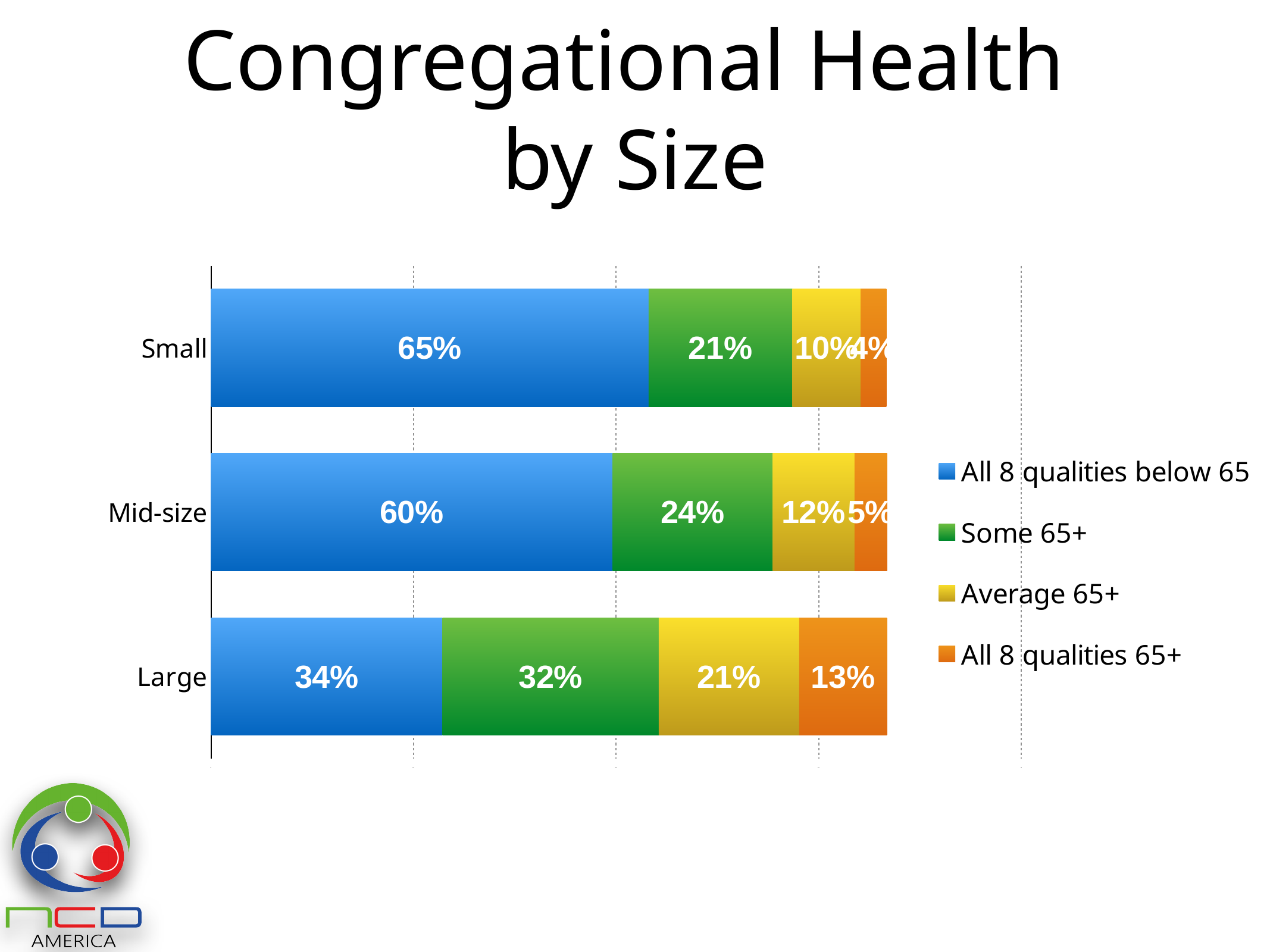
Which size category has the highest share with all 8 qualities below 65? Small What is the title of the slide? Congregational Health by Size Which size category has the lowest share with all 8 qualities 65+? Small How many congregation size categories are shown on the chart? 3 What is the 'Some 65+' value for Mid-size congregations? 24% Which is larger: the 'Some 65+' value for Large or for Mid-size congregations? Large What percentage of Small congregations have all 8 qualities below 65? 65% What is the difference between the 'All 8 qualities below 65' values for Small and Large congregations? 31% How many series does the legend list? 4 What is the 'Average 65+' value for Small congregations? 10% What percentage of Large congregations have all 8 qualities 65+? 13% What kind of chart is shown on the slide? Stacked bar chart